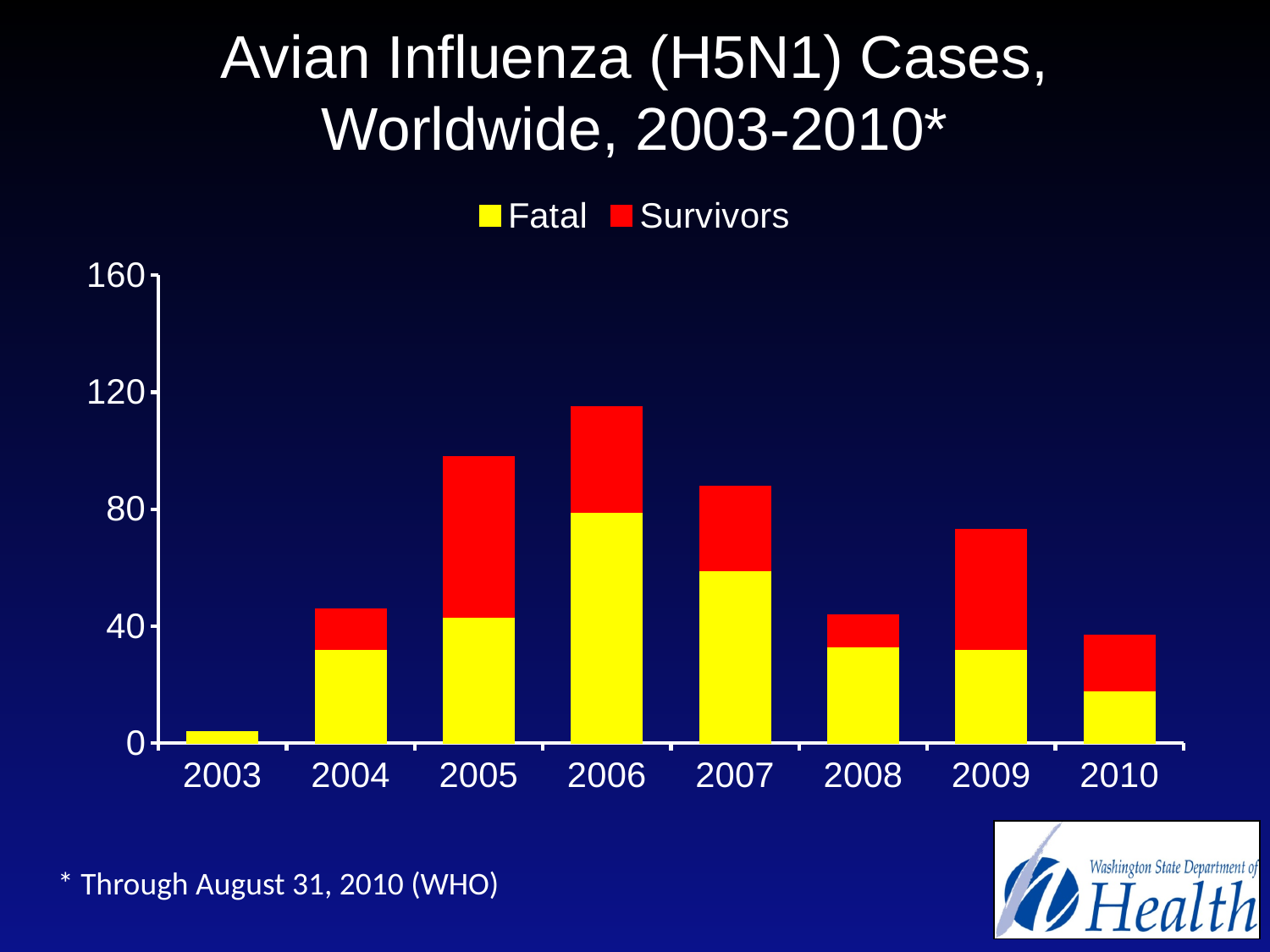
Which year has the larger total number of cases, 2005 or 2007? 2005 Is the number of Fatal cases for 2010 greater or less than 40? less Which year has the highest total number of cases? 2006 Is the total number of cases for 2006 greater or less than 80? greater What kind of chart is shown on the slide? Stacked bar chart How many years are shown on the x axis? 8 Is the total number of cases for 2003 greater or less than 40? less Which year has more Survivors, 2005 or 2006? 2005 Do the total cases rise or fall from 2006 to 2008? fall How many series does the legend list? 2 Which year has the lowest total number of cases? 2003